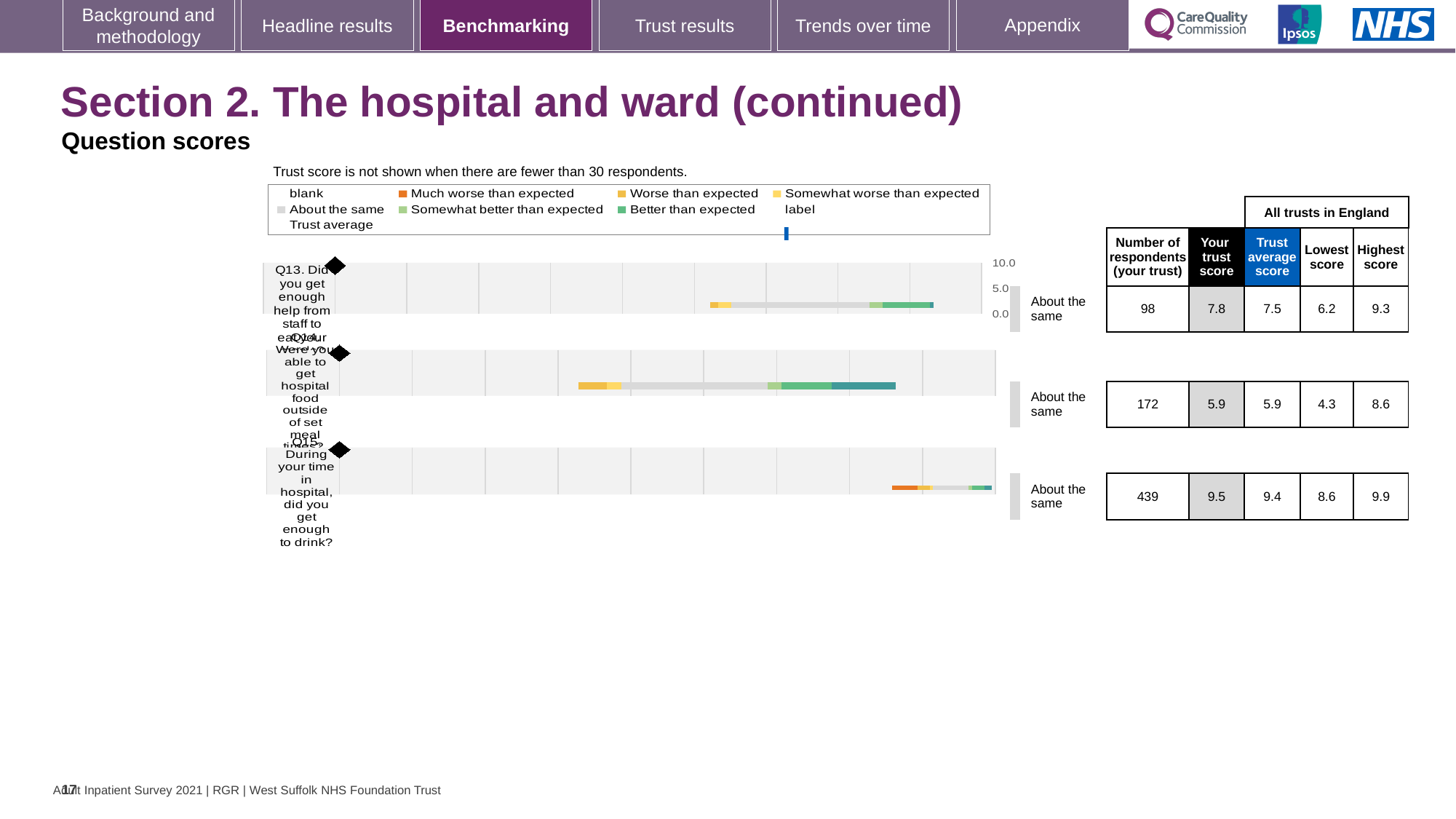
What kind of chart is used to show the question scores on this slide? bar chart What is the difference between the trust score for Q15 (9.5) and the trust score for Q13 (7.8)? 1.7 Which question has the lowest 'Your trust score'? Q14 What is the 'Highest score' across all trusts in England for Q13? 9.3 What benchmark category is shown next to the Q14 bar? About the same Which question has the highest 'Your trust score'? Q15 According to the note above the chart, when is the trust score not shown? When there are fewer than 30 respondents How many respondents are shown for Q15 (did you get enough to drink?)? 439 How many questions (rows) are plotted in the chart? 3 What is the 'Lowest score' across all trusts in England for Q14? 4.3 For Q13, which is larger: the 'Your trust score' or the 'Trust average score'? Your trust score What is the 'Your trust score' value for Q13 (Did you get enough help from staff to eat your meals?)? 7.8